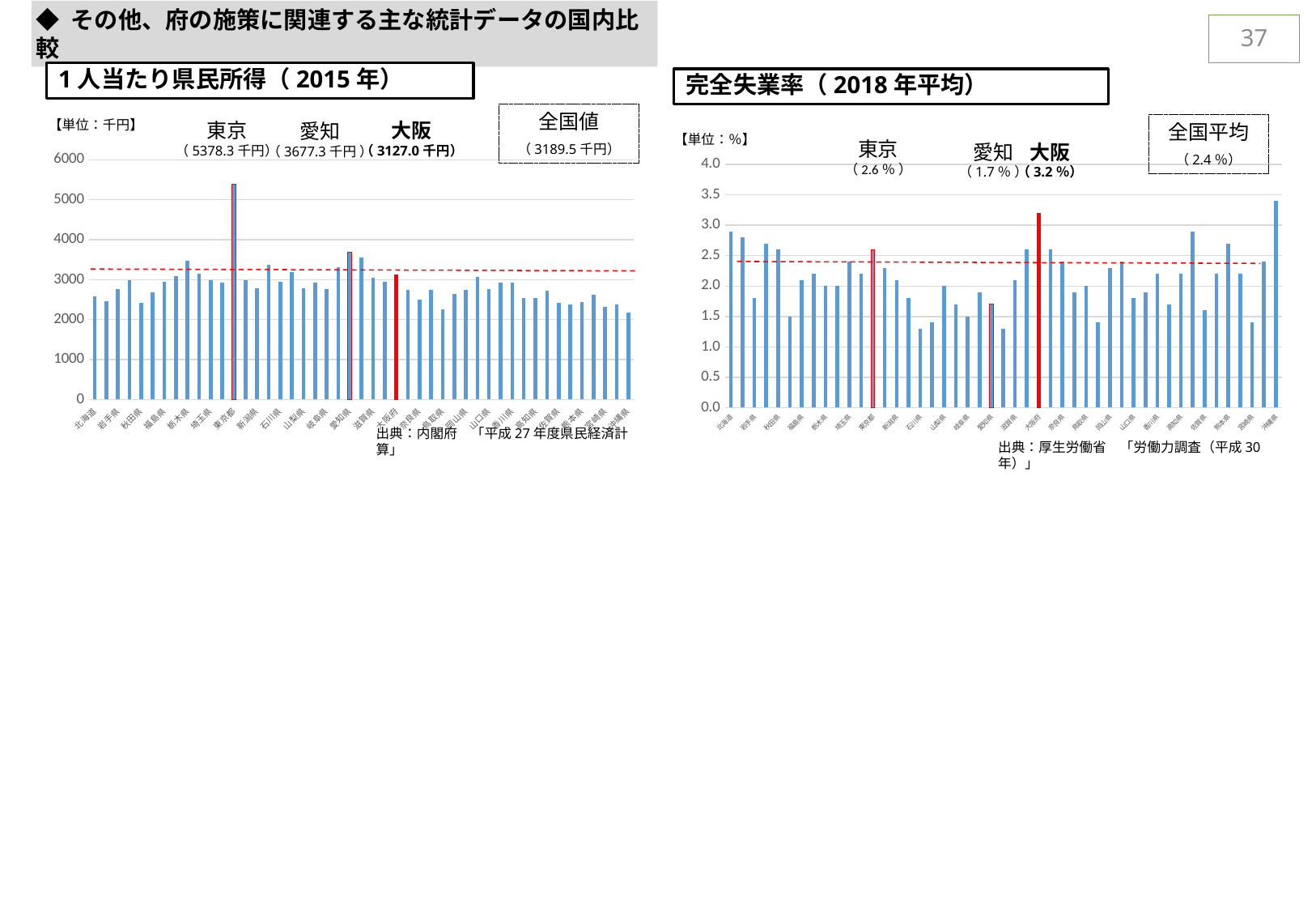
On the 1人当たり県民所得 (2015年) chart, what is the difference between 東京 and 大阪? 2251.3 千円 On the 完全失業率 (2018年平均) chart, what is the value for 大阪? 3.2 % On the 1人当たり県民所得 (2015年) chart, what is the 全国値 (national value)? 3189.5 千円 On the 完全失業率 (2018年平均) chart, which is larger, the value for 大阪 or the 全国平均? 大阪 On the 完全失業率 (2018年平均) chart, what is the value for 愛知? 1.7 % On the 1人当たり県民所得 (2015年) chart, what is the value for 大阪? 3127.0 千円 On the 1人当たり県民所得 (2015年) chart, what is the value for 東京? 5378.3 千円 On the 完全失業率 (2018年平均) chart, what is the difference between 大阪 and 東京? 0.6 % On the 1人当たり県民所得 (2015年) chart, which prefecture has the highest value? 東京 On the 完全失業率 (2018年平均) chart, what is the 全国平均 (national average)? 2.4 % What kind of chart is the 完全失業率 (2018年平均) chart? Bar chart On the 1人当たり県民所得 (2015年) chart, which is larger, the value for 大阪 or the 全国値? 全国値